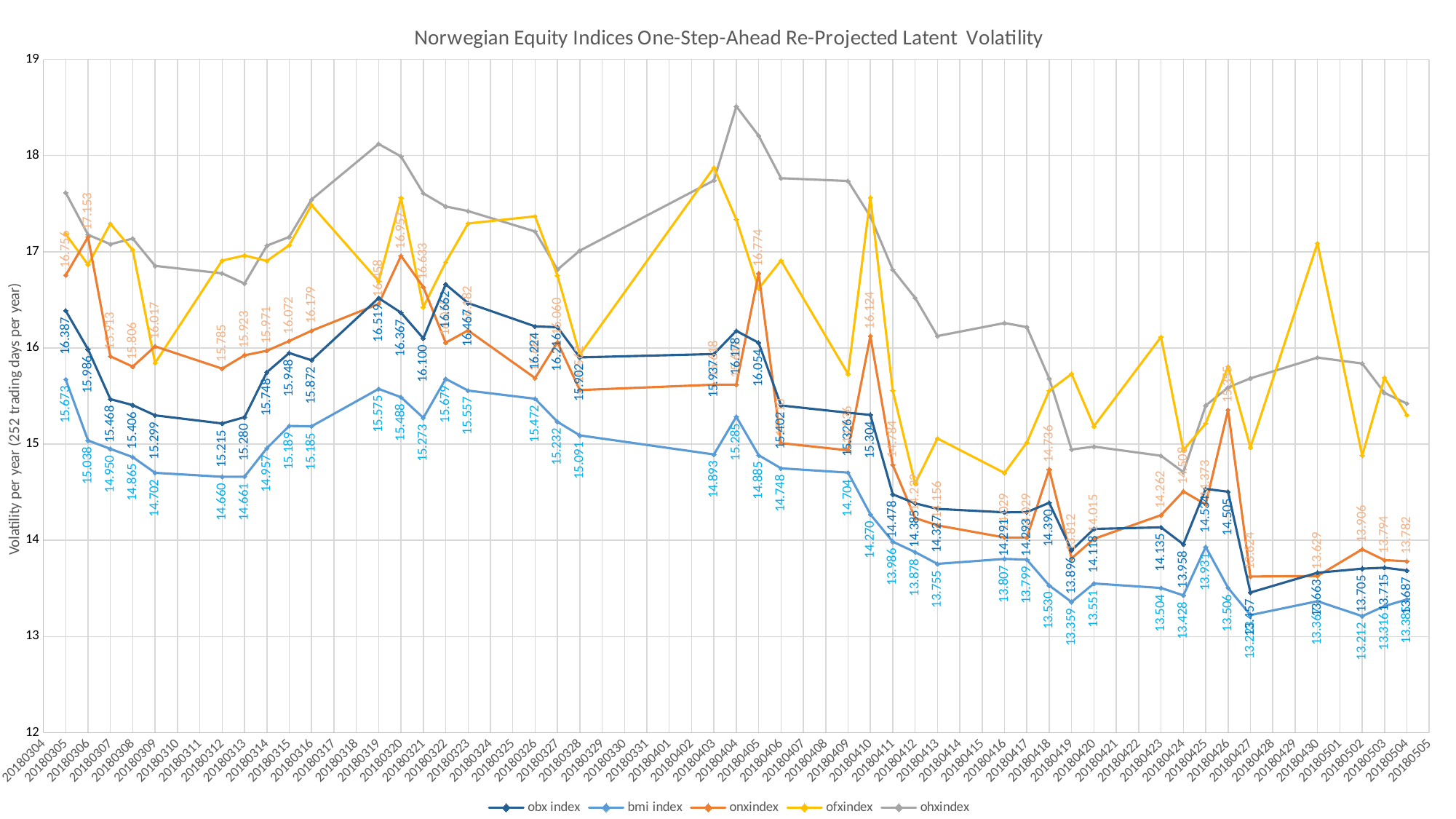
What kind of chart is shown on the slide? line chart What is the difference between the obx index and the bmi index on 20180305? 0.714 Does the obx index generally rise or fall from 20180305 to 20180504? fall Is the value of ohxindex on 20180404 greater or less than 18? greater What is the value of the bmi index on 20180309? 14.702 What is the title of the chart? Norwegian Equity Indices One-Step-Ahead Re-Projected Latent Volatility How many series does the legend list? 5 Which is larger on 20180306, onxindex or the obx index? onxindex What is the value of onxindex on 20180418? 14.736 What is the value of the obx index on 20180411? 14.478 What is the value of the obx index on 20180305? 16.387 On which date does the obx index reach its highest value? 20180322